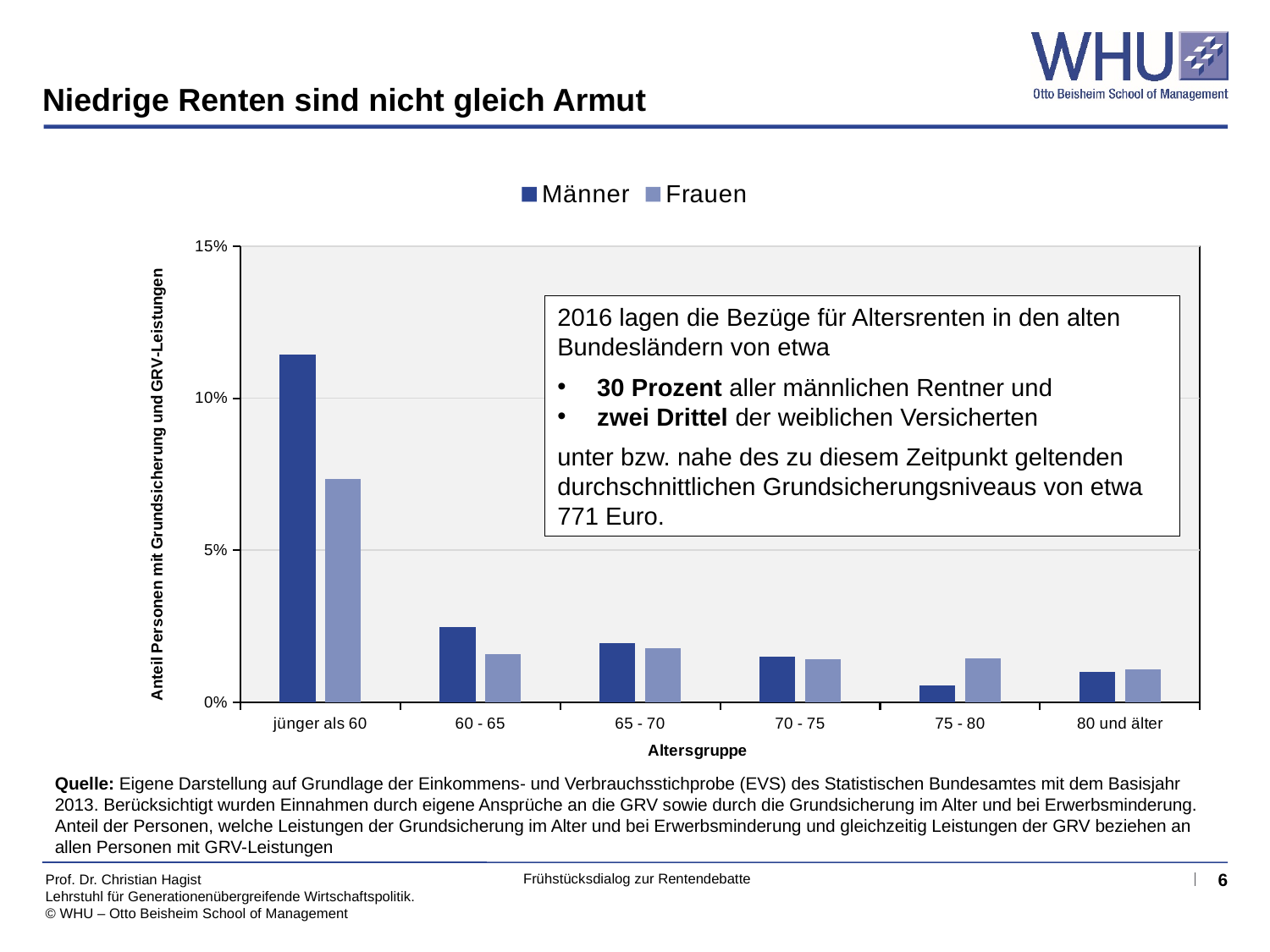
Which age group has the lowest value for Männer? 75 - 80 In the group '75 - 80', which is larger: Männer or Frauen? Frauen Is the value for Männer in the group 'jünger als 60' greater or less than 10%? greater Which age group has the highest value for Männer? jünger als 60 How many age groups are shown on the x axis? 6 Is the value for Männer in the group '60 - 65' greater or less than 5%? less How many series does the legend list? 2 Which age group has the highest value for Frauen? jünger als 60 What is the title of the x axis? Altersgruppe What kind of chart is shown on the slide? bar chart Is the value for Frauen in the group 'jünger als 60' greater or less than 5%? greater In the group 'jünger als 60', which is larger: Männer or Frauen? Männer